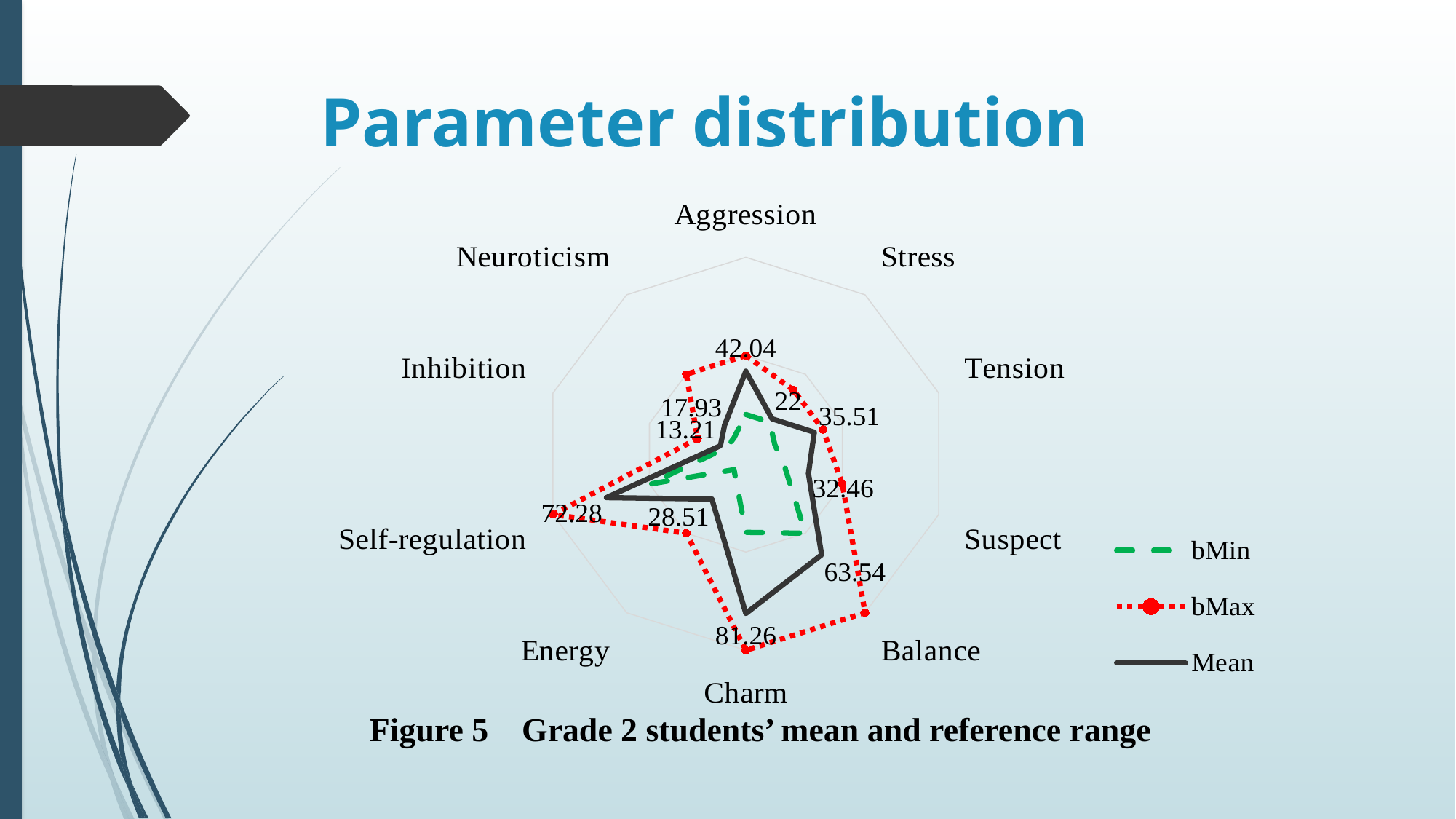
What kind of chart is shown on the slide? Radar chart How many categories (axes) does the radar chart have? 10 What is the figure caption below the chart? Figure 5 Grade 2 students' mean and reference range How many series does the legend list? 3 Which category has the lowest bMax value? Inhibition